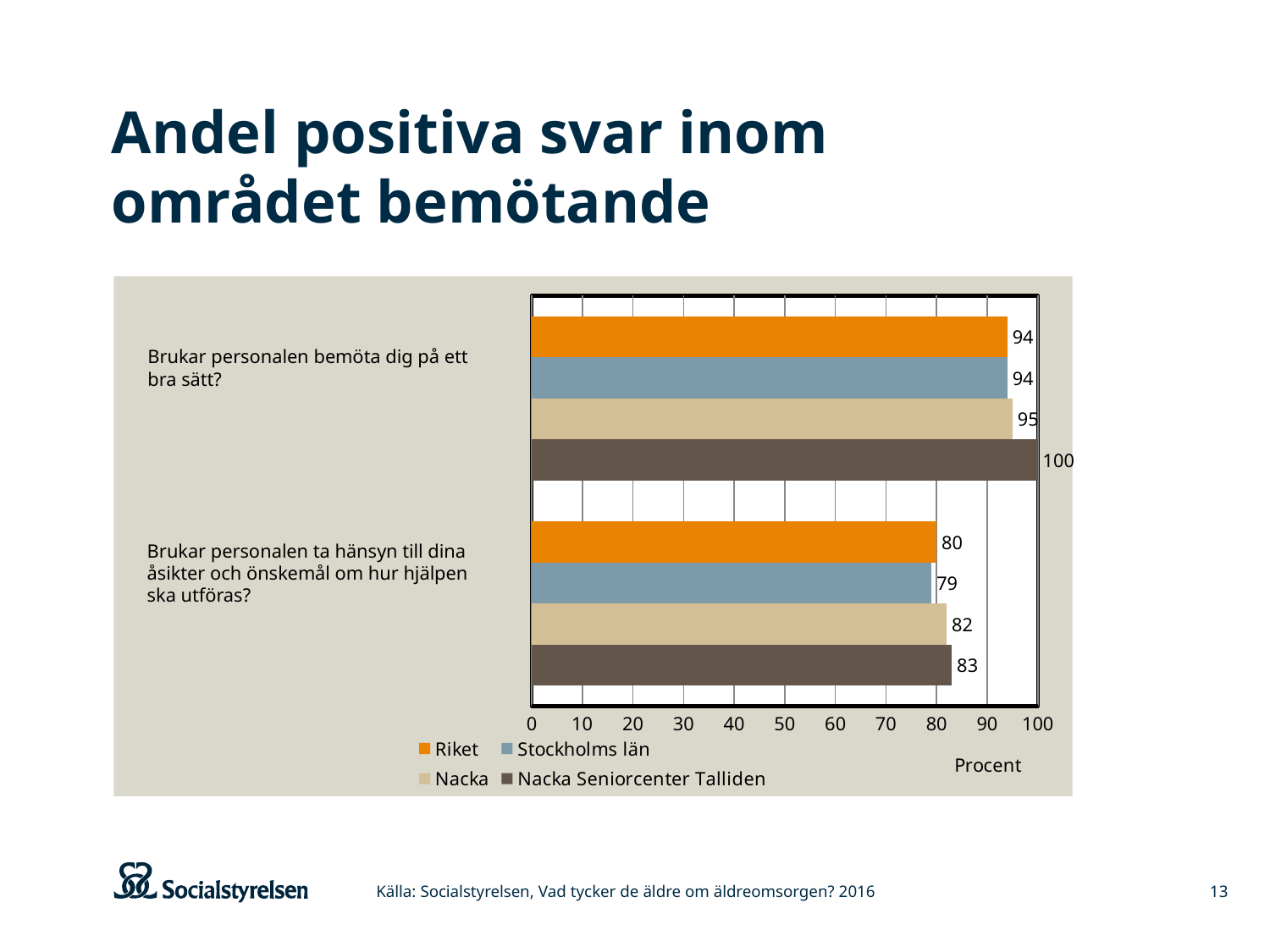
What is the value for Nacka Seniorcenter Talliden for the question "Brukar personalen bemöta dig på ett bra sätt?"? 100 Which is larger for the question "Brukar personalen ta hänsyn till dina åsikter och önskemål om hur hjälpen ska utföras?": the value for Nacka or the value for Riket? Nacka How many series does the legend list? 4 What is the label on the horizontal axis of the chart? Procent How many questions (categories) are shown on the chart? 2 Which series has the highest value for the question "Brukar personalen ta hänsyn till dina åsikter och önskemål om hur hjälpen ska utföras?"? Nacka Seniorcenter Talliden What is the value for Stockholms län for the question "Brukar personalen ta hänsyn till dina åsikter och önskemål om hur hjälpen ska utföras?"? 79 What is the value for Nacka for the question "Brukar personalen bemöta dig på ett bra sätt?"? 95 What is the value for Riket for the question "Brukar personalen ta hänsyn till dina åsikter och önskemål om hur hjälpen ska utföras?"? 80 What kind of chart is shown on the slide? Bar chart What is the difference between the Nacka Seniorcenter Talliden value and the Riket value for the question "Brukar personalen bemöta dig på ett bra sätt?"? 6 Which series has the lowest value for the question "Brukar personalen ta hänsyn till dina åsikter och önskemål om hur hjälpen ska utföras?"? Stockholms län